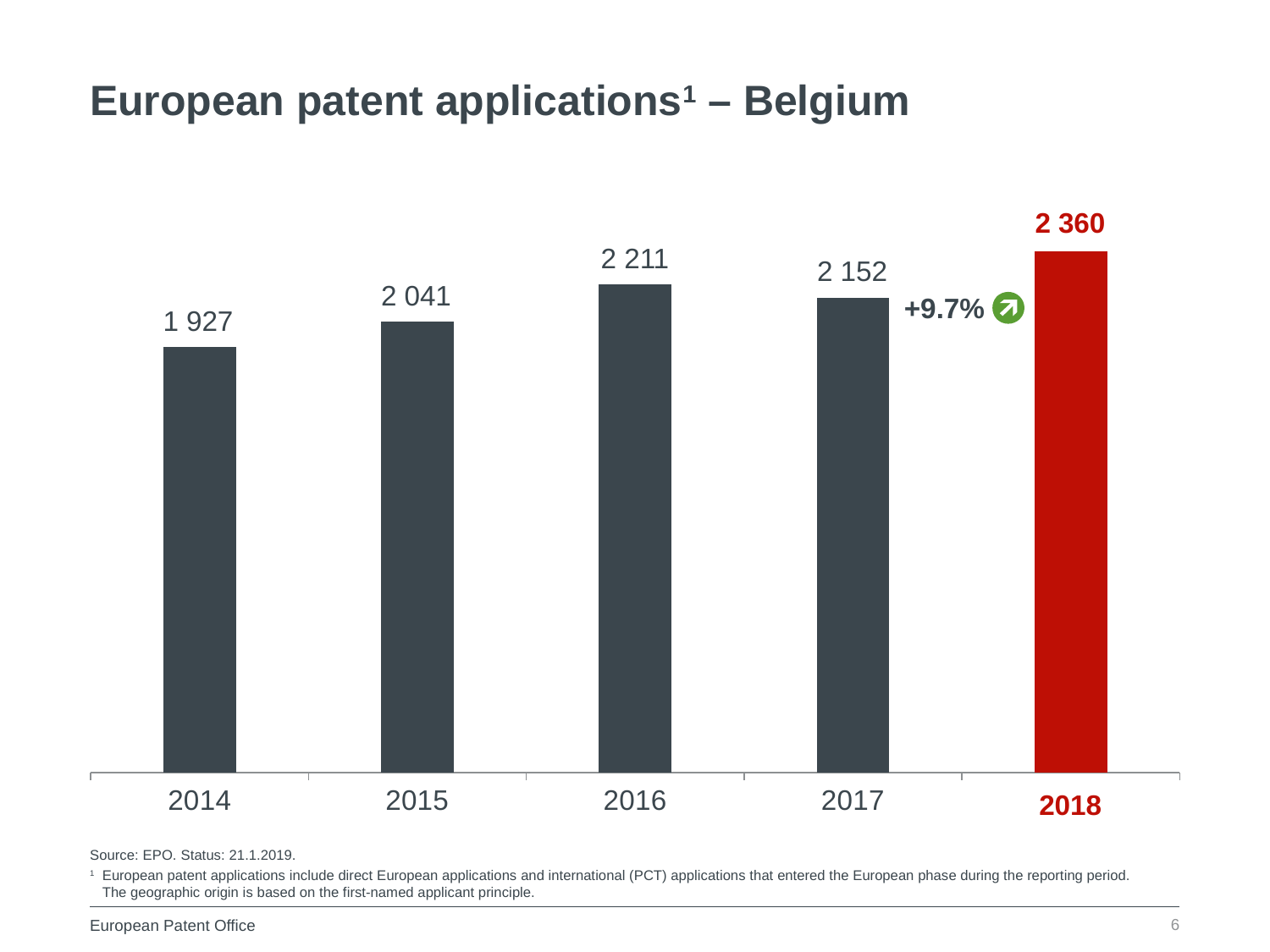
What is the difference between the 2018 and 2017 values? 208 What is the number of European patent applications from Belgium in 2014? 1 927 What is the number of European patent applications from Belgium in 2016? 2 211 Which year has the lowest number of European patent applications from Belgium? 2014 Which year has more European patent applications, 2016 or 2017? 2016 What kind of chart is shown on the slide? Bar chart How many years are shown on the chart? 5 What percentage change is shown between 2017 and 2018? +9.7% What is the number of European patent applications from Belgium in 2018? 2 360 Which bar is highlighted in red? 2018 Which year has the highest number of European patent applications from Belgium? 2018 What is the difference between the 2016 and 2015 values? 170